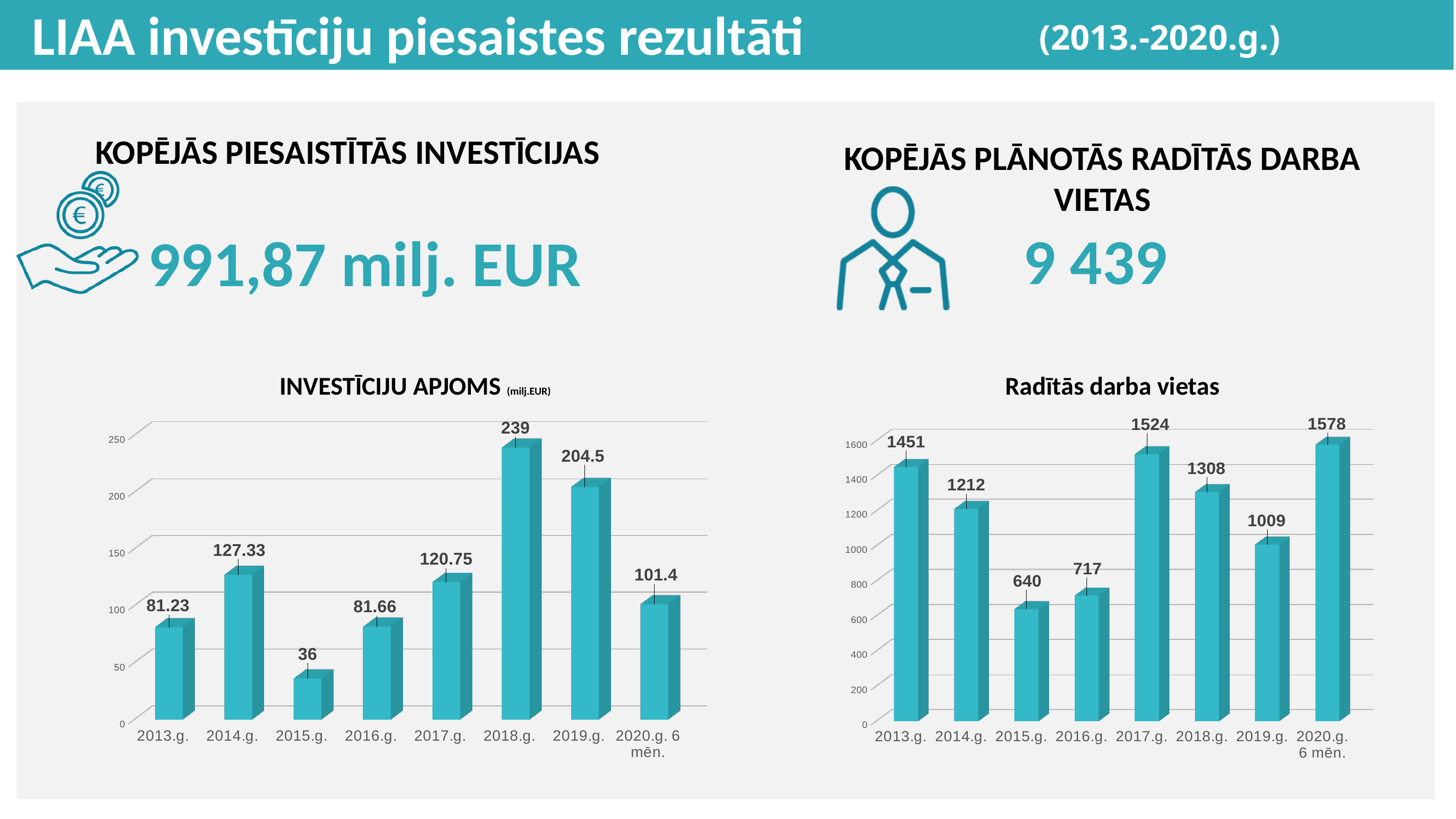
In the 'INVESTĪCIJU APJOMS' chart, what is the value for 2018.g.? 239 In the 'Radītās darba vietas' chart, what is the difference between the values for 2013.g. and 2014.g.? 239 In the 'Radītās darba vietas' chart, what is the value for 2016.g.? 717 In the 'Radītās darba vietas' chart, which year has the lowest value? 2015.g. In the 'INVESTĪCIJU APJOMS' chart, how many categories are shown on the x axis? 8 In the 'INVESTĪCIJU APJOMS' chart, is the value for 2014.g. larger or smaller than the value for 2017.g.? larger What kind of chart is the 'Radītās darba vietas' chart? bar chart In the 'Radītās darba vietas' chart, which year has the highest value? 2020.g. 6 mēn. In the 'INVESTĪCIJU APJOMS' chart, what is the value for 2020.g. 6 mēn.? 101.4 In the 'INVESTĪCIJU APJOMS' chart, what is the difference between the values for 2018.g. and 2019.g.? 34.5 In the 'Radītās darba vietas' chart, do the values rise or fall from 2018.g. to 2019.g.? fall In the 'INVESTĪCIJU APJOMS' chart, which year has the lowest value? 2015.g.